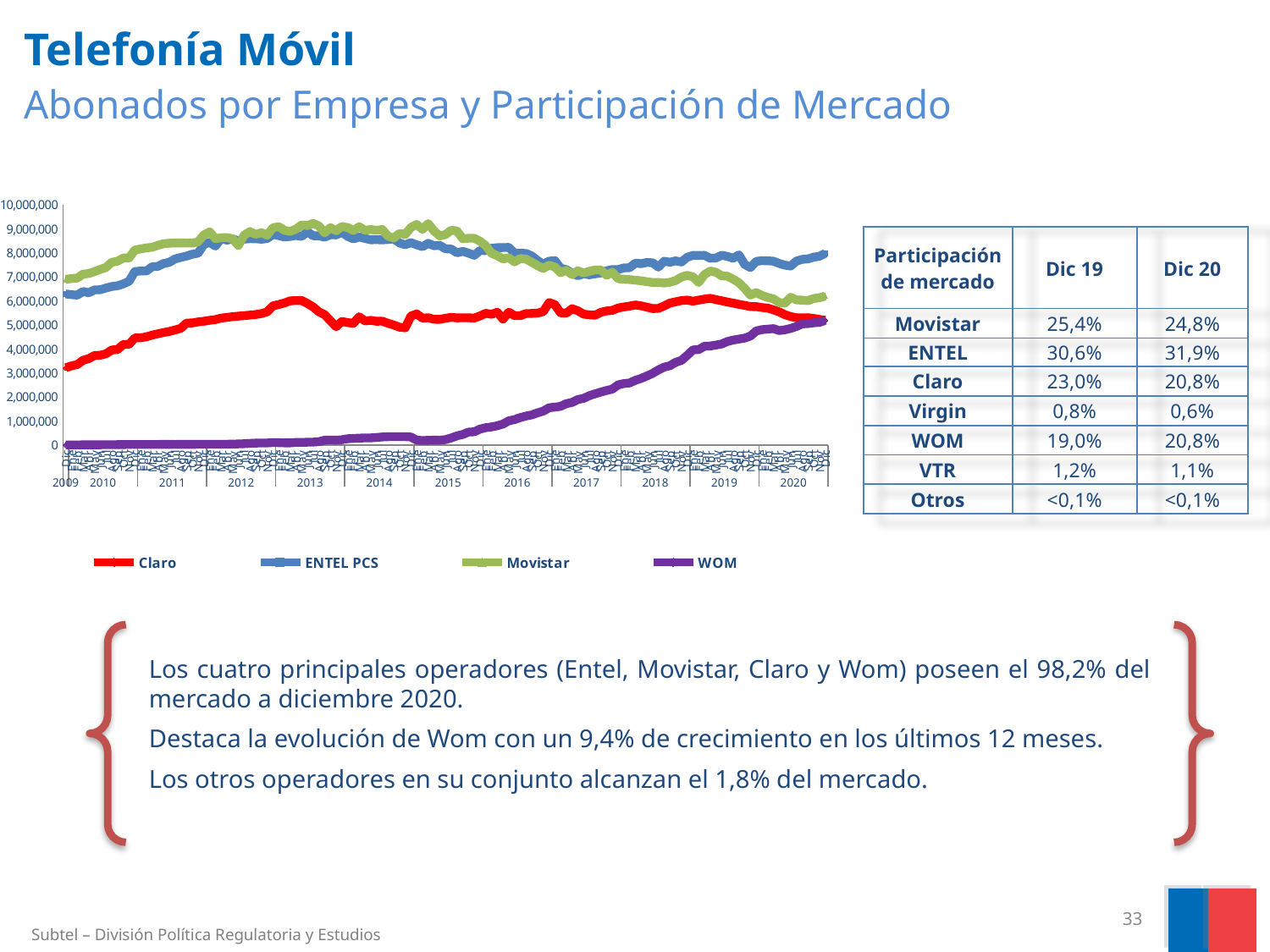
Which series is larger in 2012, ENTEL PCS or Claro? ENTEL PCS Is the value for ENTEL PCS at the end of 2020 greater or less than 7,000,000? greater Is the value for WOM in 2015 greater or less than 1,000,000? less What kind of chart is shown on the slide? line chart Is the value for Movistar at the end of 2020 greater or less than 7,000,000? less Which series has the highest number of subscribers at the end of 2020? ENTEL PCS What colour is the WOM line in the chart? purple Does the WOM line rise or fall from 2015 to 2020? rise Which series has the lowest number of subscribers in 2009? WOM Does the Movistar line rise or fall from 2014 to 2020? fall How many series does the chart legend list? 4